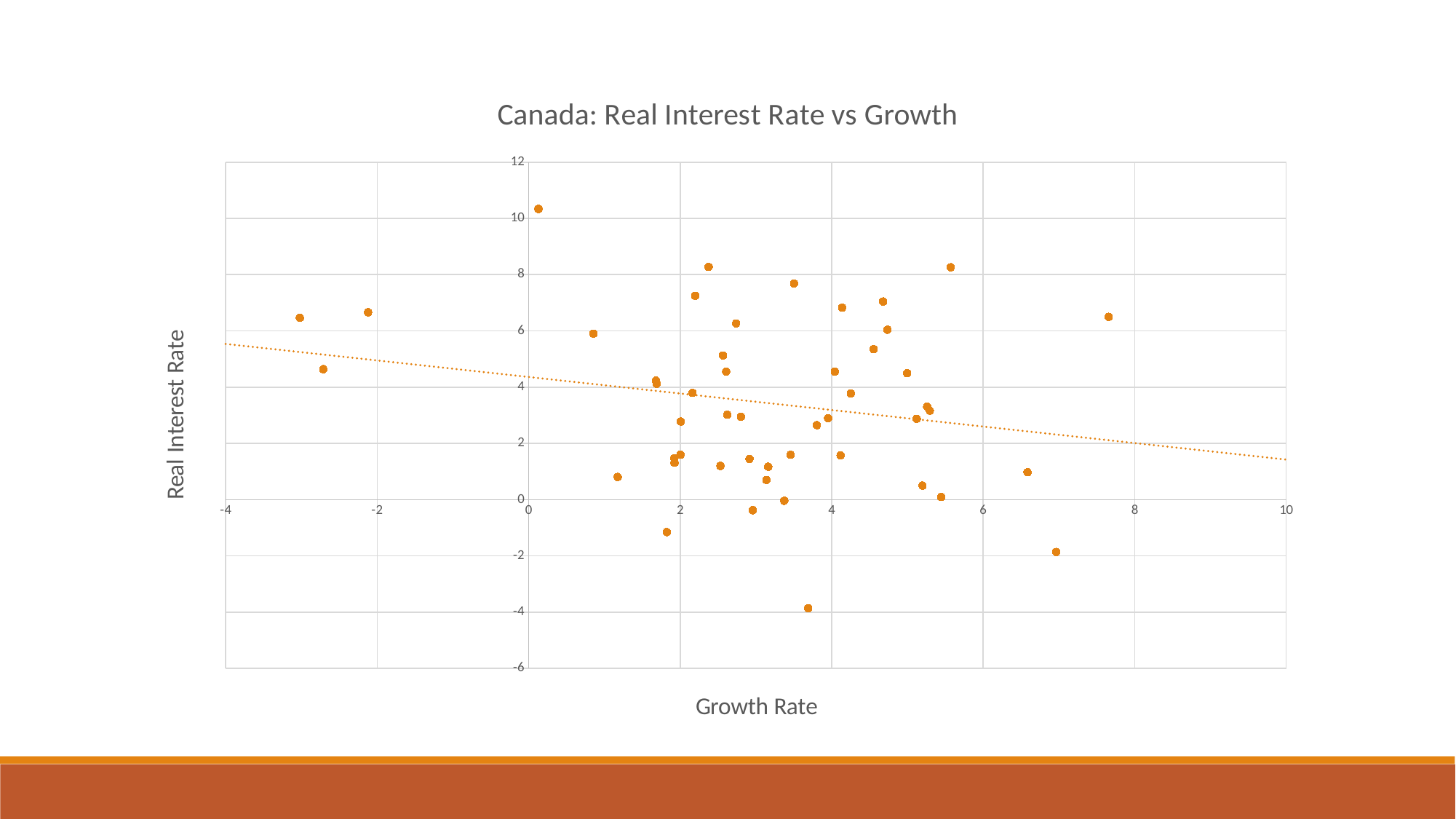
Is the lowest growth rate plotted on the chart greater or less than -2? less For the point with the highest real interest rate, is its growth rate greater or less than 2? less Does the dotted trendline rise or fall as the growth rate increases? fall For the point with the lowest real interest rate, is its growth rate greater or less than 2? greater What kind of chart is shown on the slide? scatter chart What is the label on the horizontal axis of the chart? Growth Rate What is the title of the chart? Canada: Real Interest Rate vs Growth